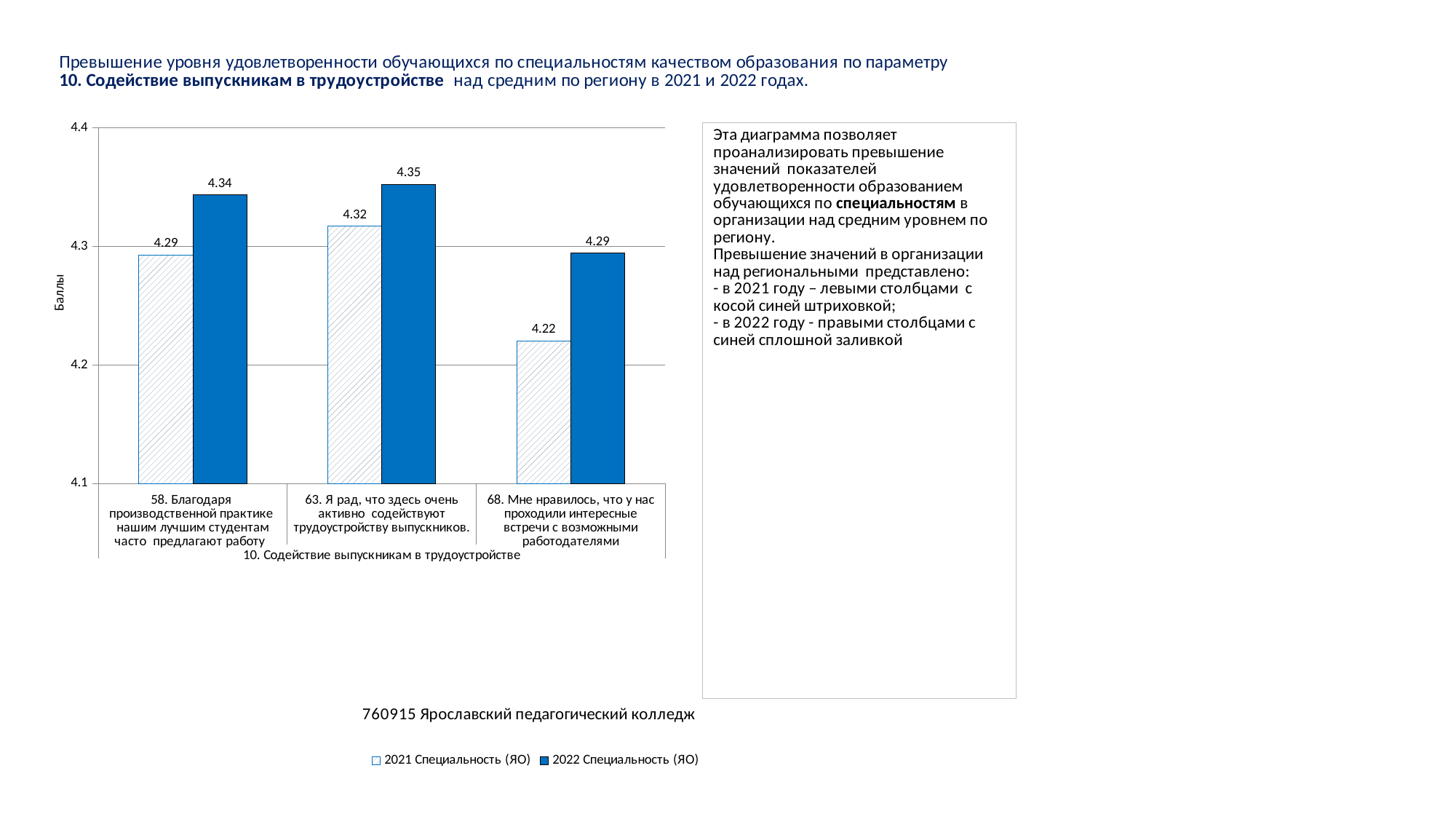
Which is larger for category 58: the 2021 value or the 2022 value? 2022 value What is the label of the vertical axis? Баллы What kind of chart is shown on the slide? bar chart Which category has the highest 2022 Специальность (ЯО) value? 63. Я рад, что здесь очень активно содействуют трудоустройству выпускников. Which category has the lowest 2021 Специальность (ЯО) value? 68. Мне нравилось, что у нас проходили интересные встречи с возможными работодателями Is the 2021 value for category 68 greater or less than 4.3? less What is the 2021 Специальность (ЯО) value for category 68 (Мне нравилось, что у нас проходили интересные встречи с возможными работодателями)? 4.22 How many series does the legend list? 2 What is the difference between the 2022 and 2021 values for category 68? 0.07 What is the 2021 Специальность (ЯО) value for category 58 (Благодаря производственной практике нашим лучшим студентам часто предлагают работу)? 4.29 What is the 2022 Специальность (ЯО) value for category 63 (Я рад, что здесь очень активно содействуют трудоустройству выпускников)? 4.35 How many categories are shown on the x axis? 3